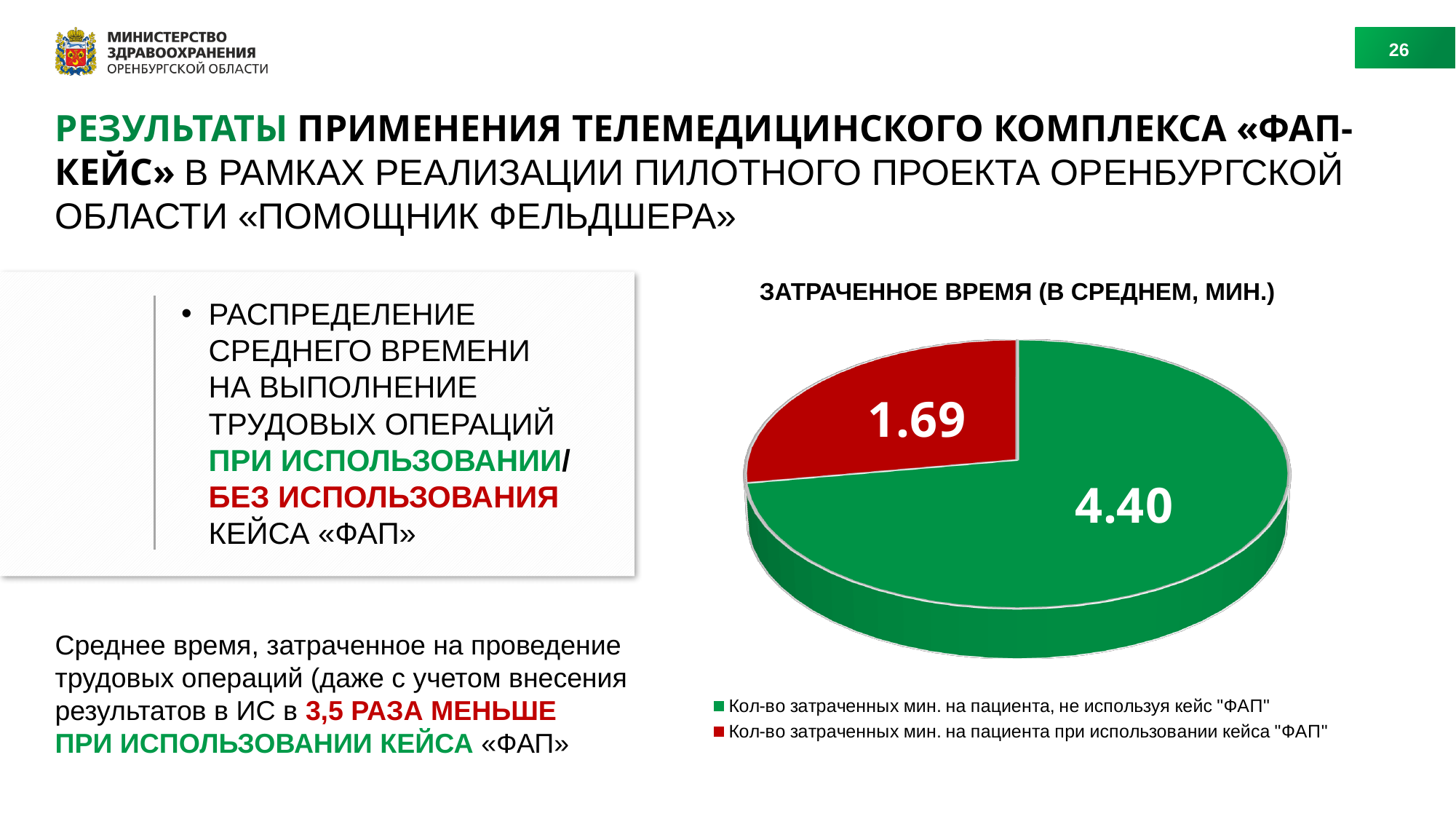
Which category has the largest slice of the pie? Кол-во затраченных мин. на пациента, не используя кейс "ФАП" What type of chart is shown on the slide? pie chart Which category has the smallest slice of the pie? Кол-во затраченных мин. на пациента при использовании кейса "ФАП" What is the value for "Кол-во затраченных мин. на пациента, не используя кейс "ФАП""? 4.40 What is the difference between the time without using the "ФАП" case and the time using the "ФАП" case? 2.71 Which is larger: the time per patient without using the "ФАП" case or the time using the "ФАП" case? without using the "ФАП" case What is the total of the two values shown in the pie chart? 6.09 How many entries does the legend list? 2 What is the title of the chart? ЗАТРАЧЕННОЕ ВРЕМЯ (В СРЕДНЕМ, МИН.) What colour is the slice for "Кол-во затраченных мин. на пациента при использовании кейса "ФАП""? red How many slices does the pie chart have? 2 What is the value for "Кол-во затраченных мин. на пациента при использовании кейса "ФАП""? 1.69